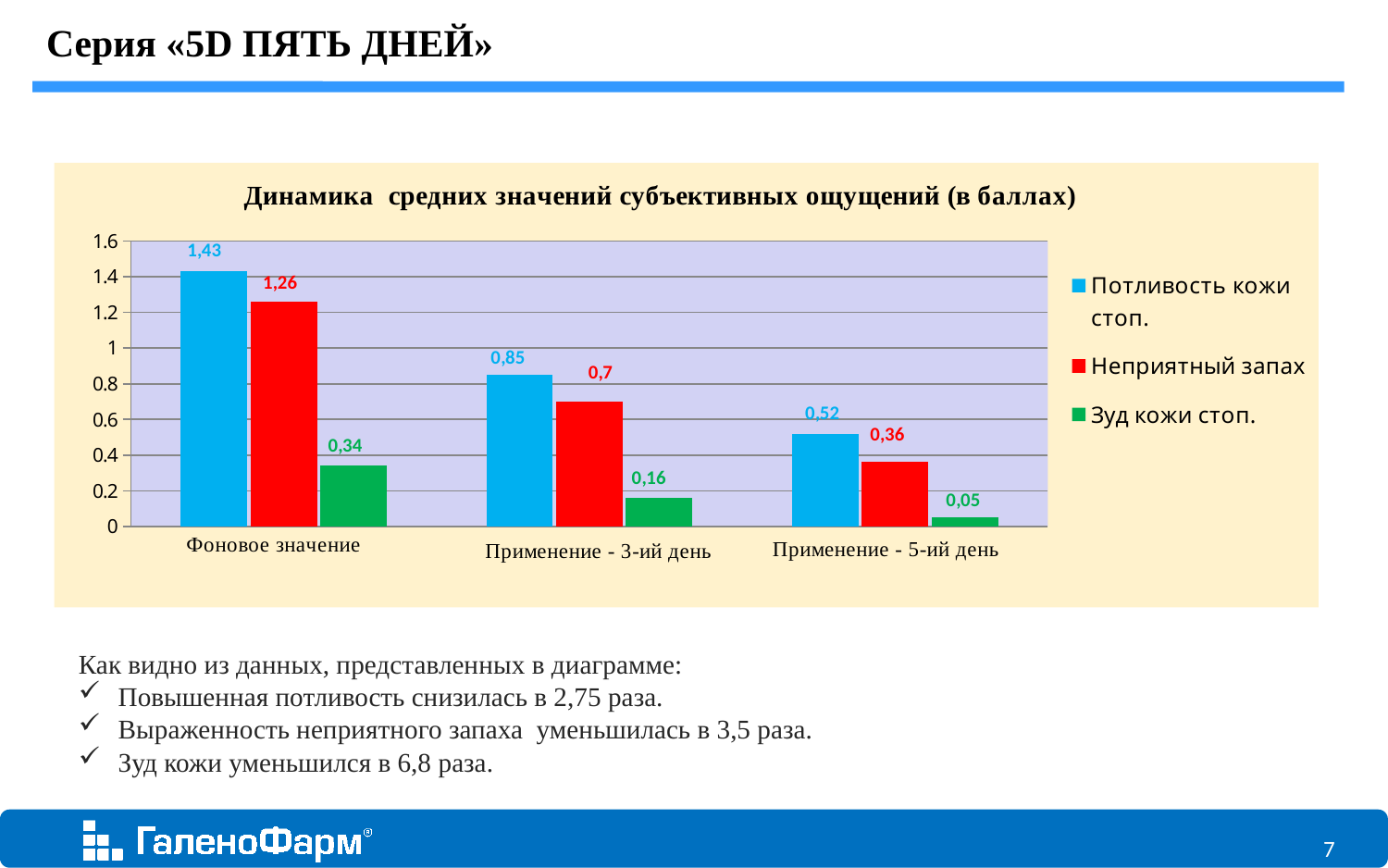
What is the value for Неприятный запах at Применение - 3-ий день? 0,7 What is the value for Зуд кожи стоп. at Применение - 5-ий день? 0,05 How many categories are shown on the x axis? 3 What is the title of the chart? Динамика средних значений субъективных ощущений (в баллах) Do the values for Зуд кожи стоп. rise or fall from Фоновое значение to Применение - 5-ий день? Fall What is the difference between the Потливость кожи стоп. values at Фоновое значение and Применение - 5-ий день? 0,91 How many series does the legend list? 3 Which is larger: Неприятный запах at Фоновое значение or Потливость кожи стоп. at Применение - 3-ий день? Неприятный запах at Фоновое значение Which series has the highest value at Фоновое значение? Потливость кожи стоп. What is the value for Потливость кожи стоп. at Фоновое значение? 1,43 What kind of chart is shown on the slide? Bar chart Which series has the lowest value at Применение - 3-ий день? Зуд кожи стоп.